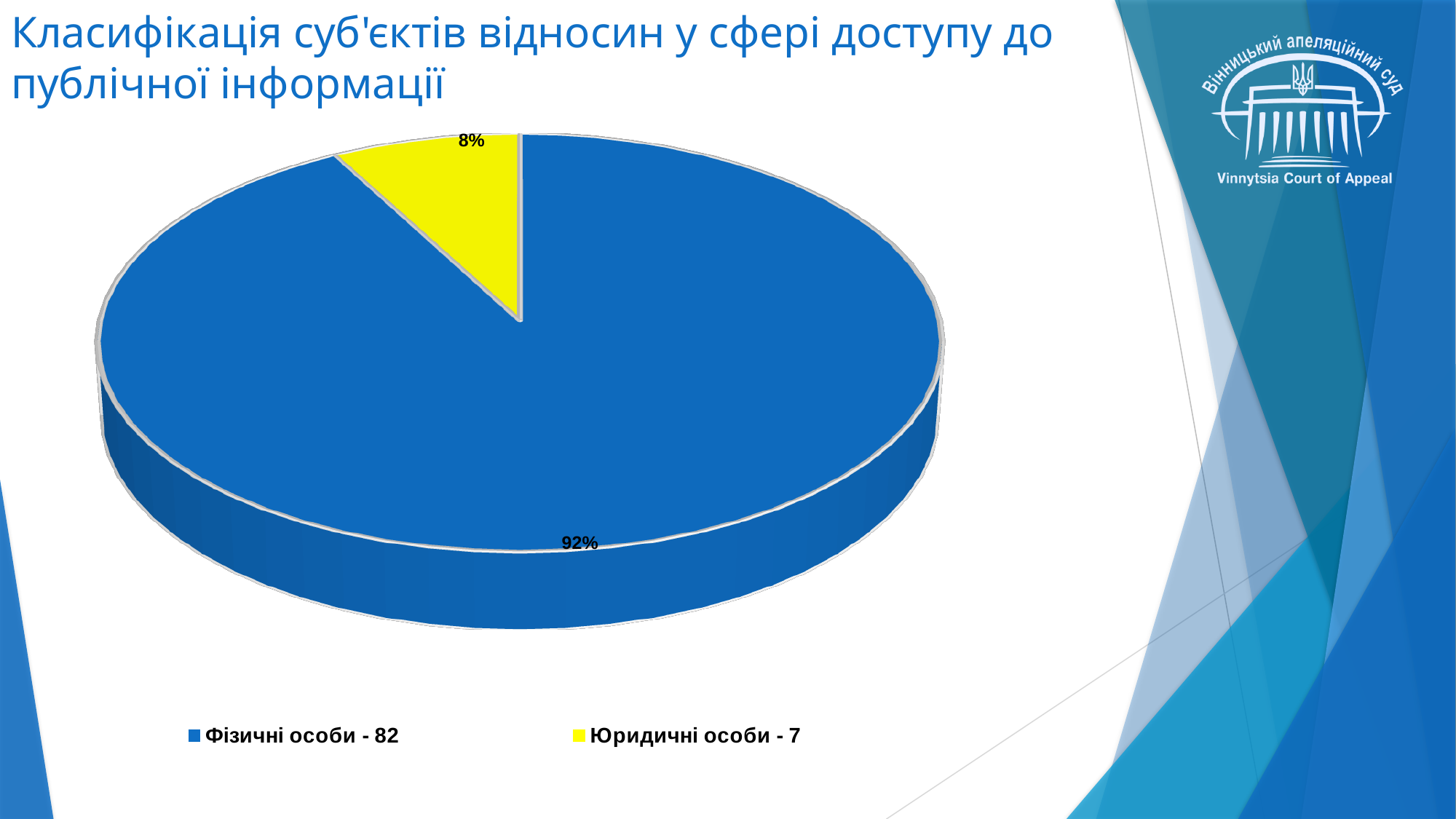
How many slices does the pie chart have? 2 What kind of chart is shown on the slide? Pie chart Which slice is the smallest in the pie chart? Юридичні особи - 7 Which slice is the largest in the pie chart? Фізичні особи - 82 What percentage share is shown for the slice 'Фізичні особи - 82'? 92% What is the title of the slide containing the pie chart? Класифікація суб'єктів відносин у сфері доступу до публічної інформації What number is shown in the legend entry for 'Фізичні особи'? 82 What colour is the 'Юридичні особи - 7' slice? Yellow What percentage share is shown for the slice 'Юридичні особи - 7'? 8% Which is larger: the share for 'Фізичні особи' or the share for 'Юридичні особи'? Фізичні особи What is the difference in percentage points between the 'Фізичні особи' slice and the 'Юридичні особи' slice? 84 How many entries does the legend list? 2